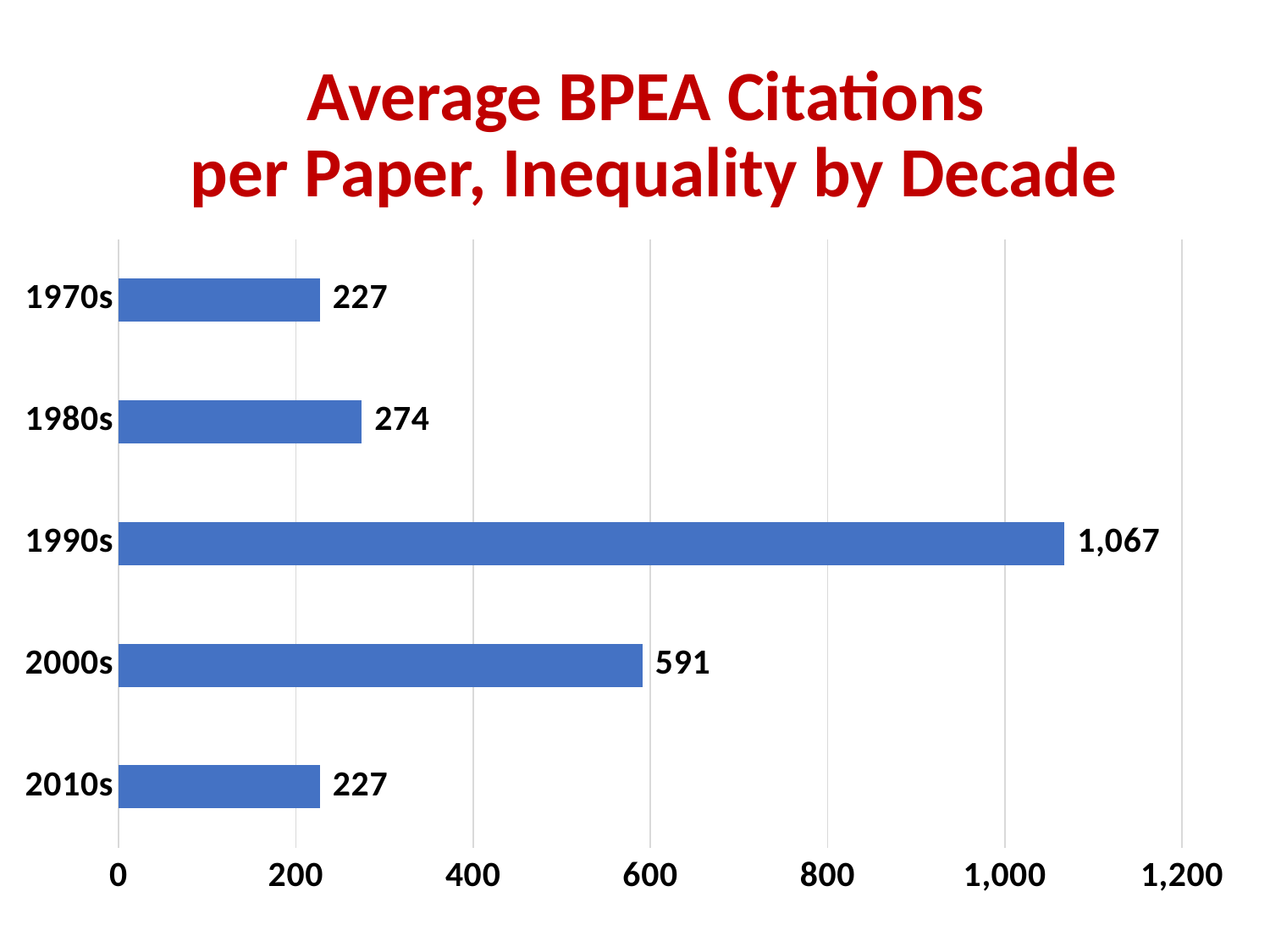
What is the value shown for the 1980s? 274 What is the title of the chart? Average BPEA Citations per Paper, Inequality by Decade What is the average BPEA citations per paper for the 1990s? 1,067 Which is larger, the value for the 2000s or the value for the 1980s? 2000s How many decades are shown on the chart? 5 Is the value for the 1990s greater or less than 1,000? greater Which decades share the lowest value on the chart? 1970s and 2010s Which decade has the highest average citations per paper? 1990s What is the difference between the 1990s value and the 2000s value? 476 What is the value shown for the 2000s? 591 What kind of chart is shown on the slide? Bar chart What is the difference between the 1980s value and the 1970s value? 47